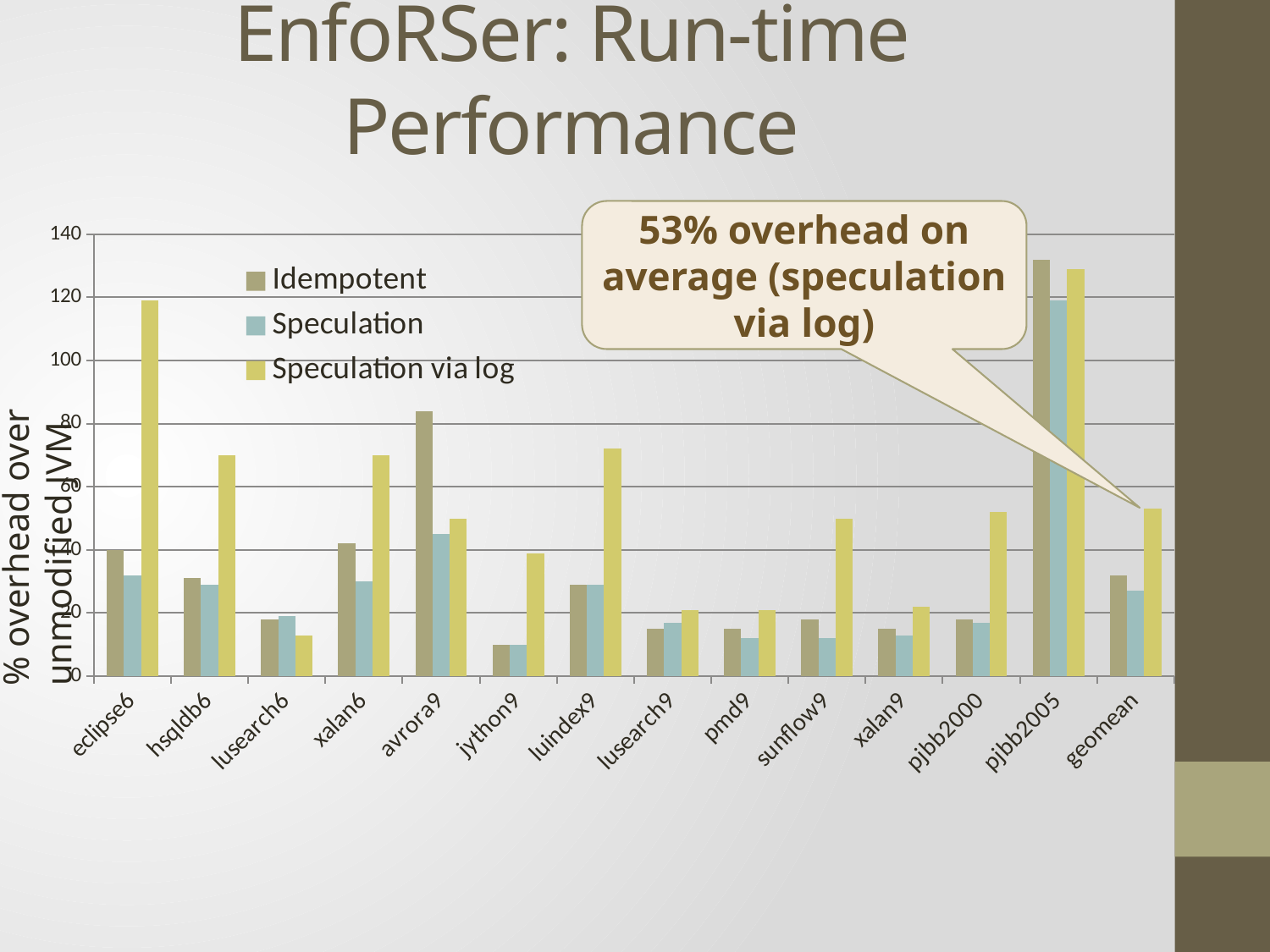
According to the callout, what is the average overhead for Speculation via log (the geomean bar)? 53% How many series does the legend list? 3 What is the y-axis label of the chart? % overhead over unmodified JVM What kind of chart is shown on the slide? bar chart What are the three series named in the legend? Idempotent, Speculation, Speculation via log Which benchmark has the highest Idempotent bar? pjbb2005 Which benchmark has the highest Speculation via log bar? pjbb2005 Which benchmark has the lowest Speculation via log bar? lusearch6 Is the Speculation via log value for eclipse6 greater or less than 100? greater How many benchmark categories are shown along the x axis? 14 Which benchmark has the lowest Idempotent bar? jython9 For xalan6, which is larger: the Idempotent value or the Speculation via log value? Speculation via log